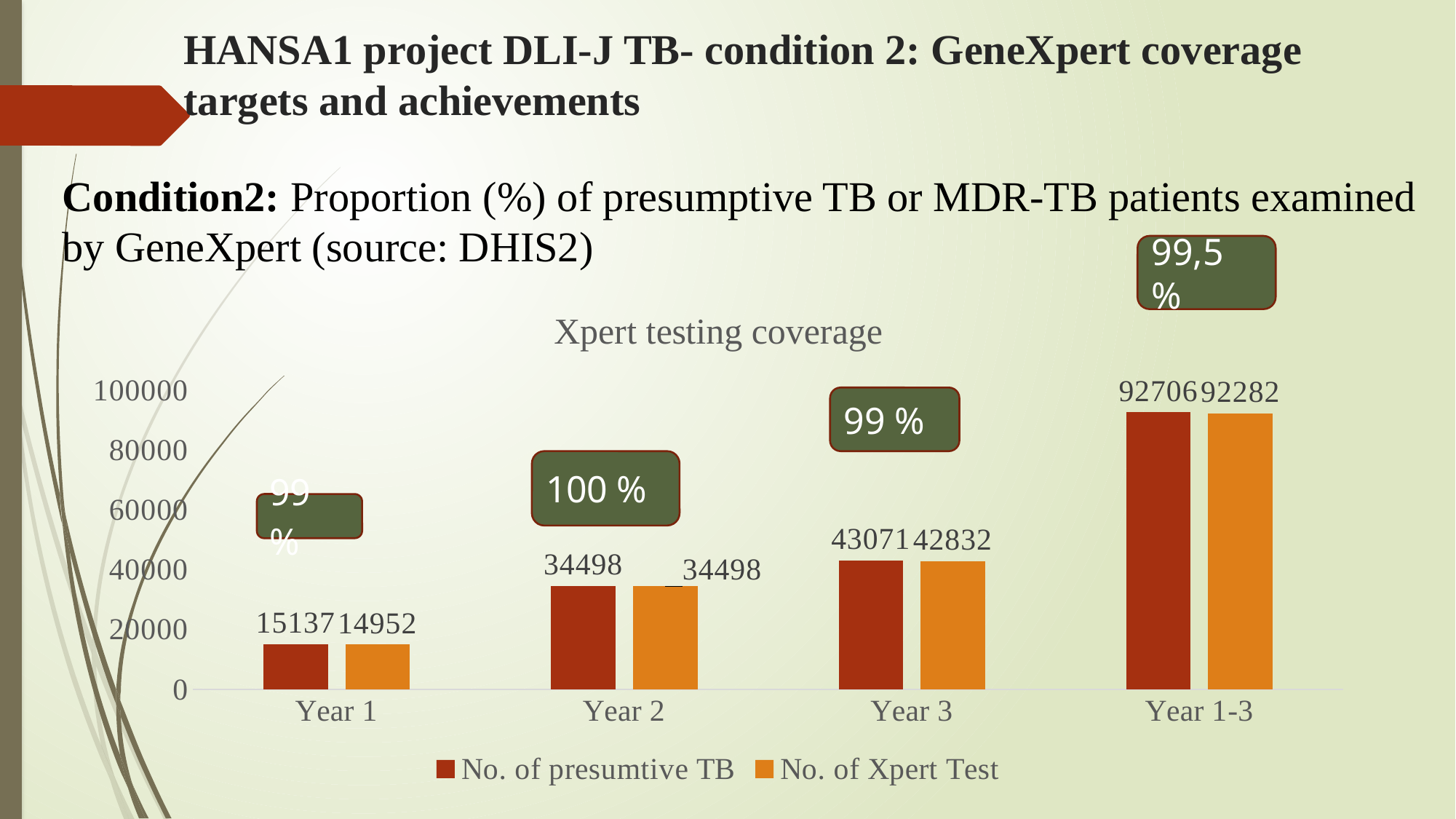
Which category has the highest number of Xpert Tests? Year 1-3 What is the number of Xpert Tests for Year 1-3? 92282 Is the number of presumptive TB for Year 2 greater or less than 40000? less What is the difference between the number of presumptive TB and the number of Xpert Tests in Year 3? 239 What is the number of presumptive TB for Year 1? 15137 How many series does the chart legend list? 2 Do the numbers of Xpert Tests rise or fall from Year 1 to Year 3? rise What is the title of the chart? Xpert testing coverage How many categories are shown on the x axis of the chart? 4 What type of chart is shown on the slide? bar chart What is the number of Xpert Tests for Year 3? 42832 Which category has the lowest number of presumptive TB? Year 1